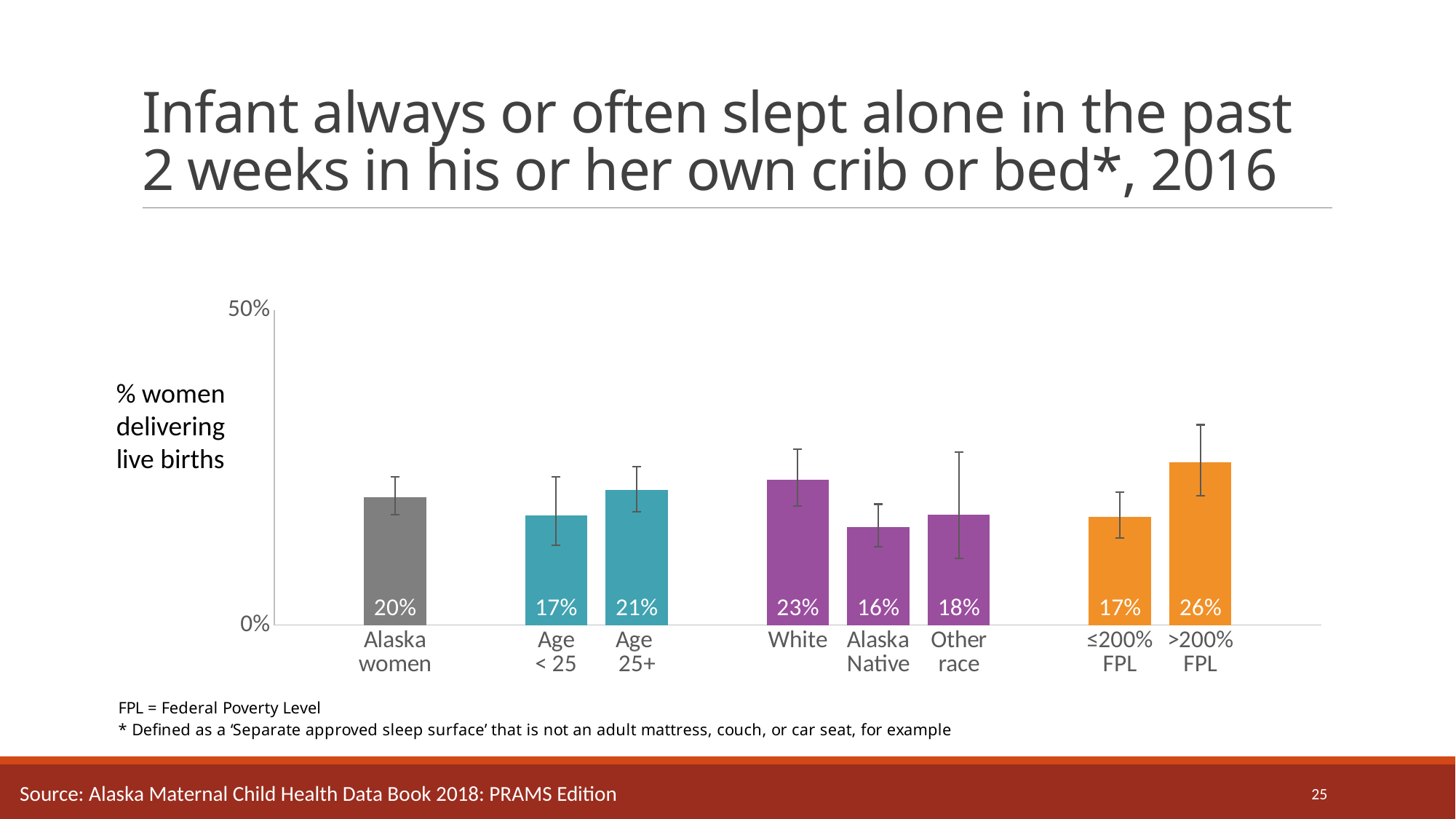
Which is larger, the value for Age < 25 or Age 25+? Age 25+ Which category has the highest value? >200% FPL Which category has the lowest value? Alaska Native What is the difference between the values for White and Alaska Native? 7% What is the value for Age 25+? 21% What kind of chart is shown on the slide? Bar chart How many categories are shown in the chart? 8 What is the label on the y axis of the chart? % women delivering live births What is the difference between the values for >200% FPL and ≤200% FPL? 9% What is the value for Alaska women? 20% What is the value for >200% FPL? 26% What is the value for Alaska Native? 16%